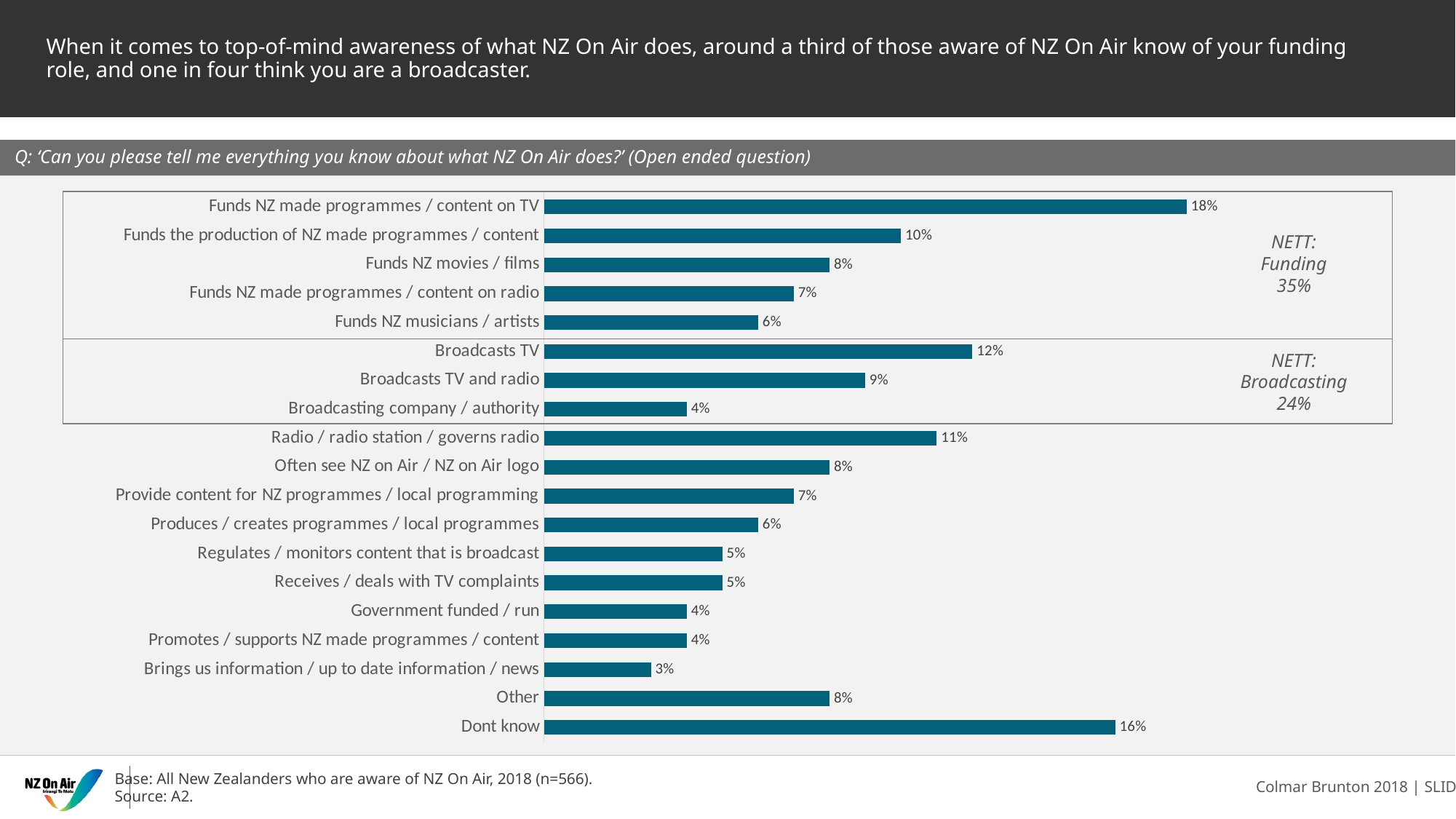
Which is larger: 'Radio / radio station / governs radio' or 'Funds the production of NZ made programmes / content'? Radio / radio station / governs radio What kind of chart is shown on the slide? Bar chart Which category has the lowest value on the chart? Brings us information / up to date information / news Which category has the highest value on the chart? Funds NZ made programmes / content on TV What percentage said NZ On Air broadcasts TV? 12% What is the value for 'Dont know'? 16% What is the NETT Broadcasting percentage shown on the chart? 24% What is the value for 'Brings us information / up to date information / news'? 3% What is the difference between 'Funds NZ made programmes / content on TV' and 'Broadcasts TV'? 6 percentage points How many categories are plotted on the chart? 19 What percentage of respondents said NZ On Air funds NZ made programmes / content on TV? 18% What is the NETT Funding percentage shown on the chart? 35%